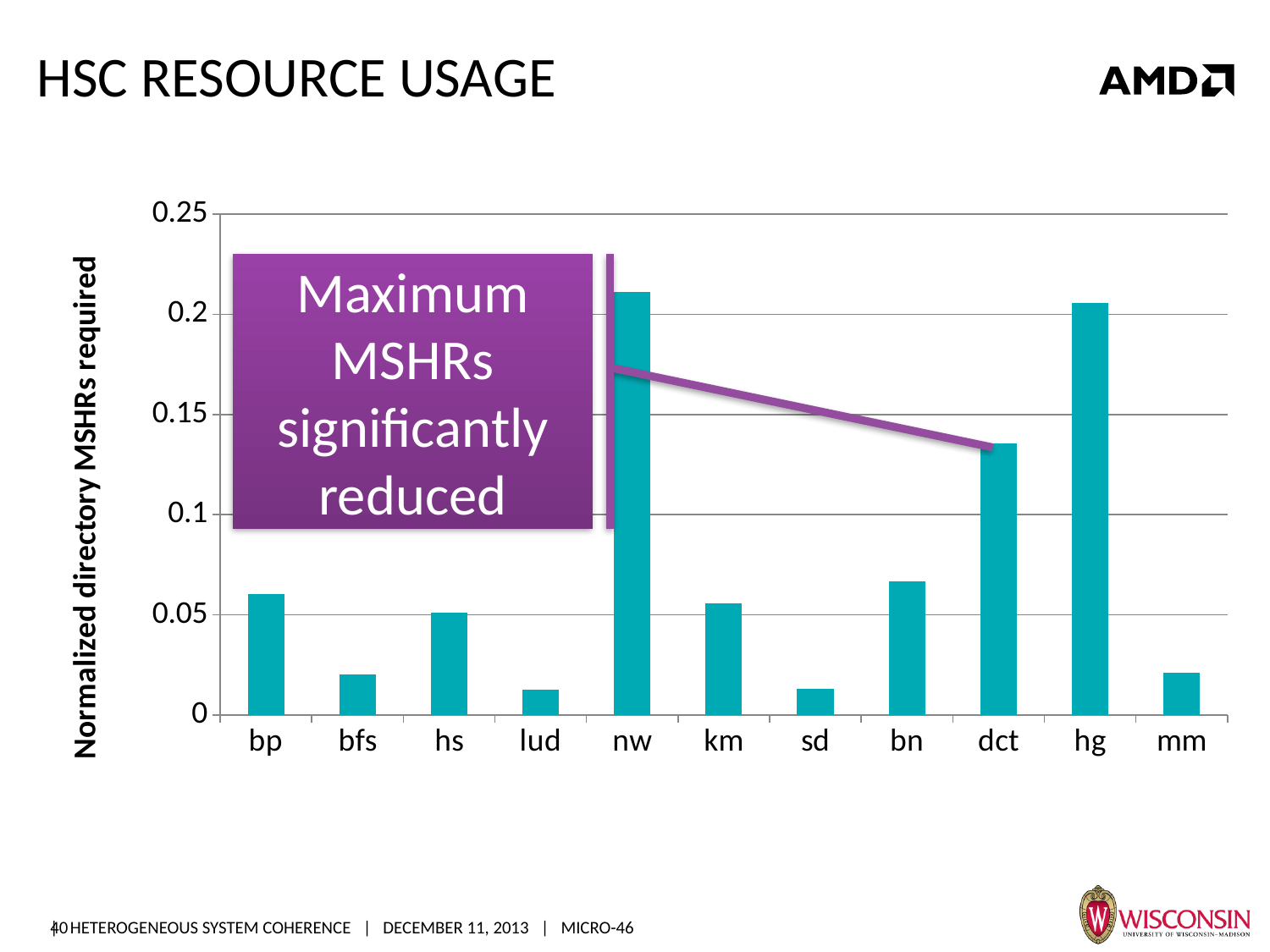
Which has the larger value, hg or bn? hg What is the label on the y axis of the chart? Normalized directory MSHRs required Is the value for bfs greater or less than 0.05? less Is the value for nw greater or less than 0.2? greater How many categories are plotted along the x axis of the chart? 11 Is the value for dct greater or less than 0.1? greater What kind of chart is shown on the slide? bar chart Which has the larger value, bp or bfs? bp Which has the larger value, nw or dct? nw